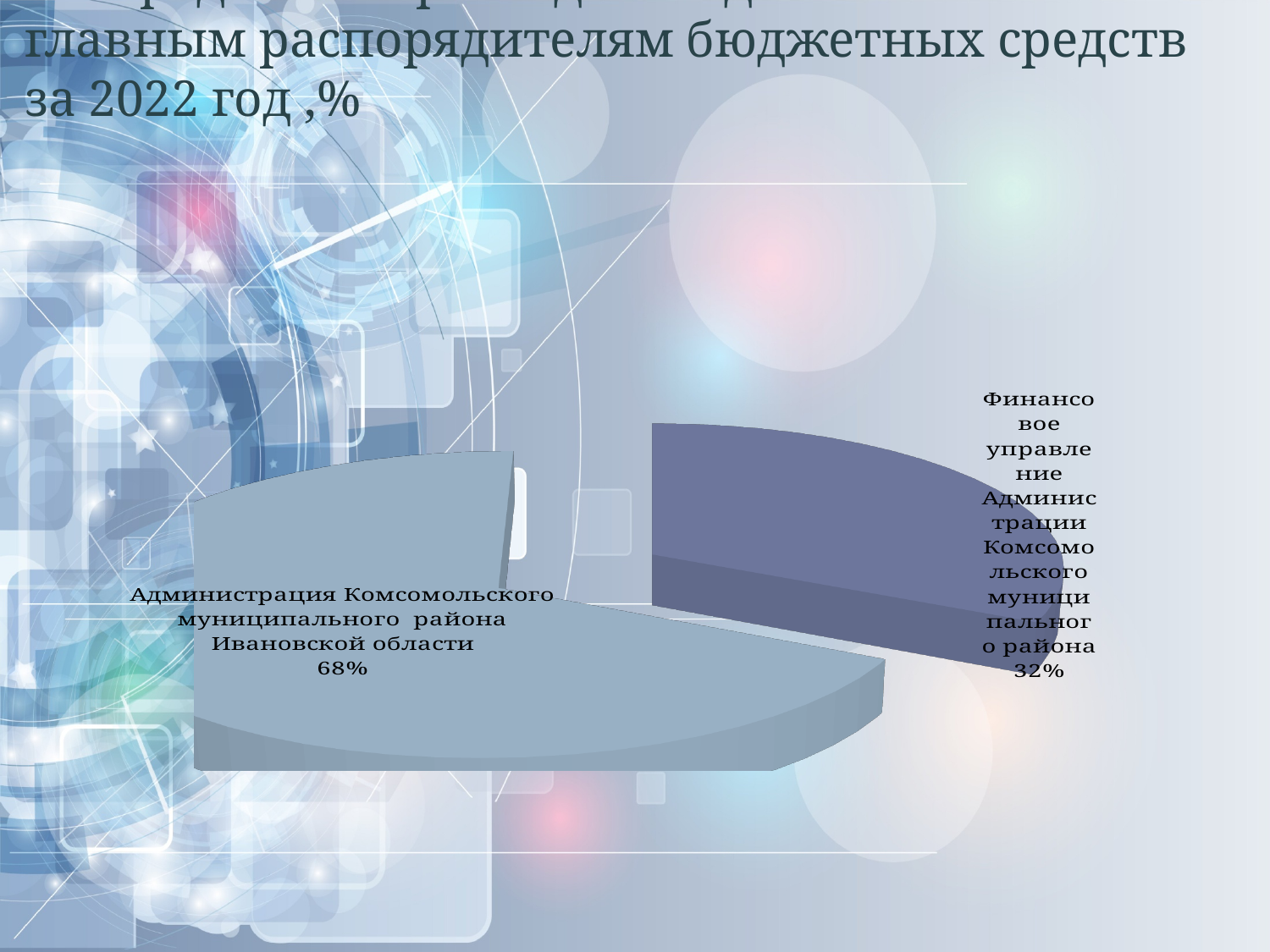
Which slice of the pie chart is the largest? Администрация Комсомольского муниципального района Ивановской области What is the total of the two percentages shown on the pie chart? 100% By how many percentage points does the share of Администрация Комсомольского муниципального района Ивановской области exceed that of Финансовое управление? 36 What kind of chart is shown on the slide? pie chart Which slice of the pie chart is the smallest? Финансовое управление Администрации Комсомольского муниципального района Is the share for Финансовое управление Администрации Комсомольского муниципального района greater or less than 50%? less How many slices does the pie chart have? 2 What year does the chart title say the data is for? 2022 What share of the pie is labelled "Финансовое управление Администрации Комсомольского муниципального района"? 32% Is the pie chart drawn in 3D or flat 2D? 3D Which is larger: the share for Администрация Комсомольского муниципального района Ивановской области or the share for Финансовое управление Администрации Комсомольского муниципального района? Администрация Комсомольского муниципального района Ивановской области What share of the pie is labelled "Администрация Комсомольского муниципального района Ивановской области"? 68%